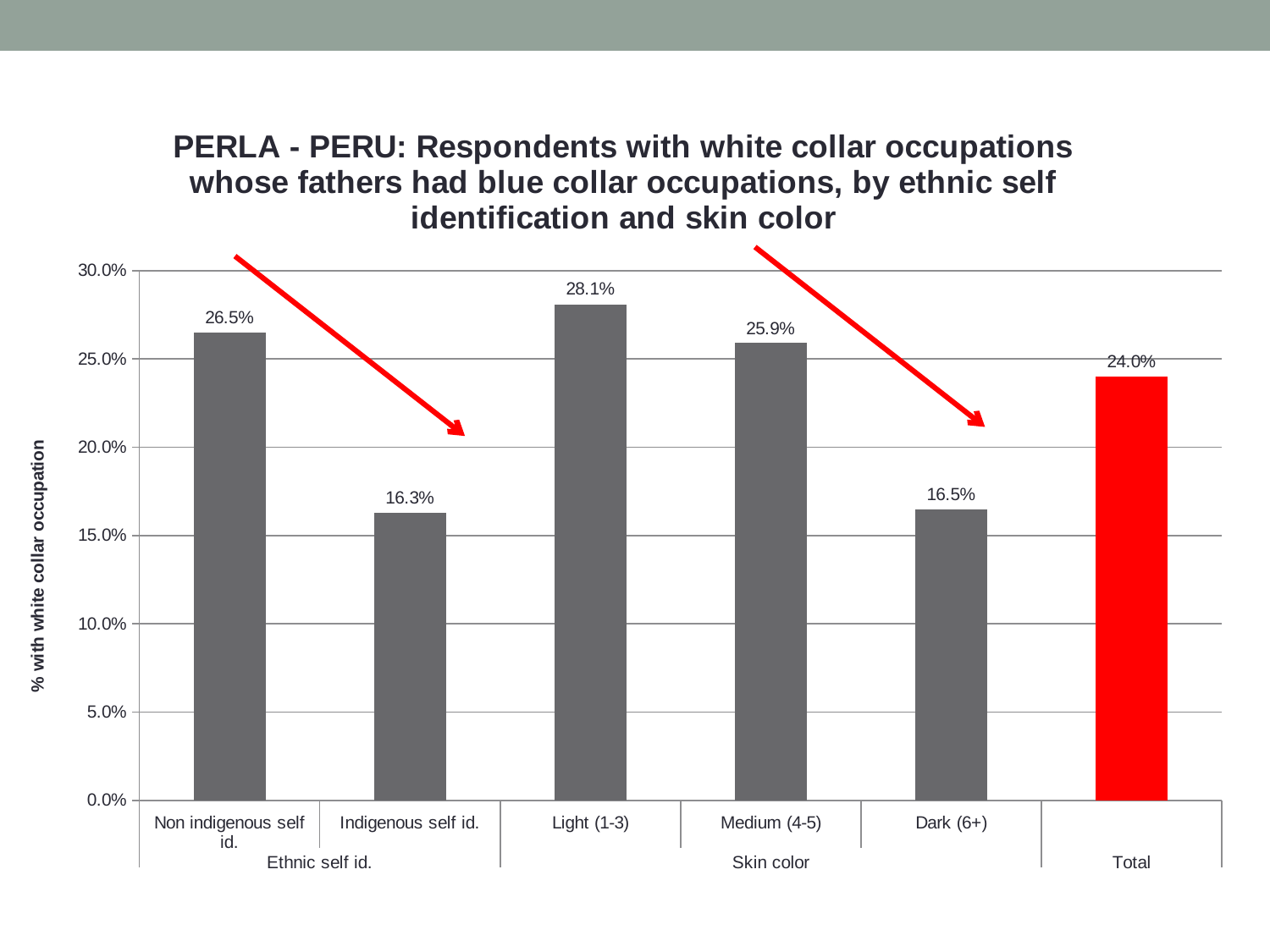
What is the difference between the values for Non indigenous self id. and Indigenous self id.? 10.2% What is the value for Non indigenous self id.? 26.5% Which is larger, the value for Medium (4-5) or the value for Total? Medium (4-5) What is the value for Light (1-3)? 28.1% What kind of chart is shown on the slide? Bar chart What is the difference between the values for Light (1-3) and Dark (6+)? 11.6% Which category has the highest value? Light (1-3) What is the value for Total? 24.0% What is the value for Indigenous self id.? 16.3% Which category has the lowest value? Indigenous self id. How many bars are plotted in the chart? 6 What is the value for Dark (6+)? 16.5%